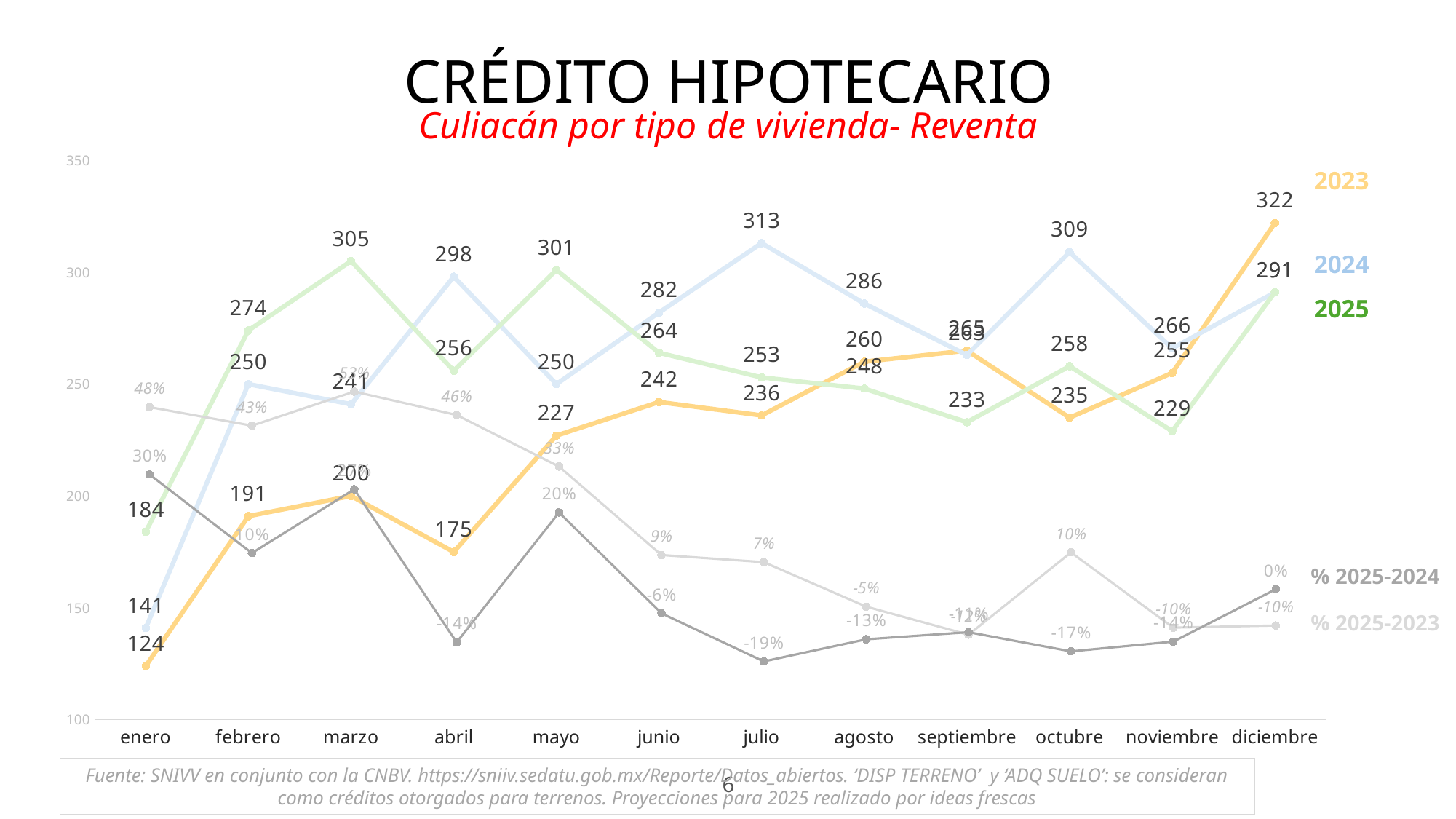
How many series does the legend list? 5 What kind of chart is shown on the slide? Line chart What is the value for 2024 in julio? 313 What is the subtitle shown in red below the main title? Culiacán por tipo de vivienda- Reventa What is the value for 2023 in diciembre? 322 In which month does the 2023 series reach its highest value? diciembre What is the value for 2025 in marzo? 305 How many months are plotted along the x axis? 12 In which month does the 2025 series have its lowest value? enero What is the difference between the 2025 and 2023 values in marzo? 105 What is the % 2025-2023 value for enero? 48% Which series has the larger value in abril, 2024 or 2025? 2024